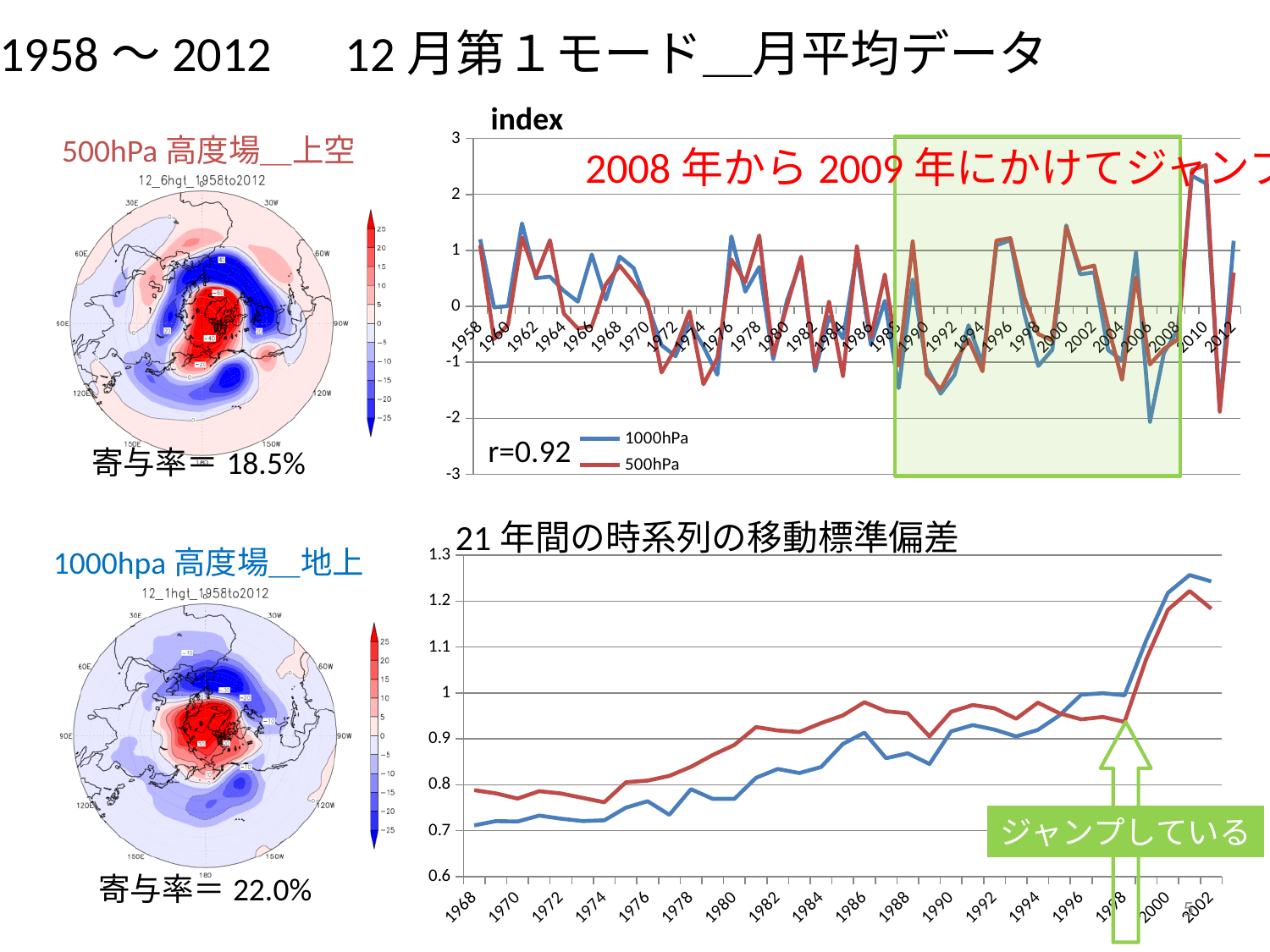
How many series does the legend of the top "index" chart list? 2 In the bottom chart "21年間の時系列の移動標準偏差", is the value of the red line in 2000 greater or less than 1.1? greater What kind of chart is the top chart titled "index"? line chart In the bottom chart "21年間の時系列の移動標準偏差", which line is higher in 1980, the red line or the blue line? the red line In the bottom chart "21年間の時系列の移動標準偏差", is the value of the blue line in 1968 greater or less than 0.8? less In the top "index" chart, what are the two series named in the legend? 1000hPa and 500hPa In the bottom chart "21年間の時系列の移動標準偏差", do the values generally rise or fall from 1968 to 2002? rise In the top "index" chart, what correlation value r is printed on the chart? r=0.92 In the bottom chart "21年間の時系列の移動標準偏差", which line is higher in 2002, the red line or the blue line? the blue line What kind of chart is the bottom chart titled "21年間の時系列の移動標準偏差"? line chart In the top "index" chart, is the value for 500hPa in 1973 greater or less than -1? greater